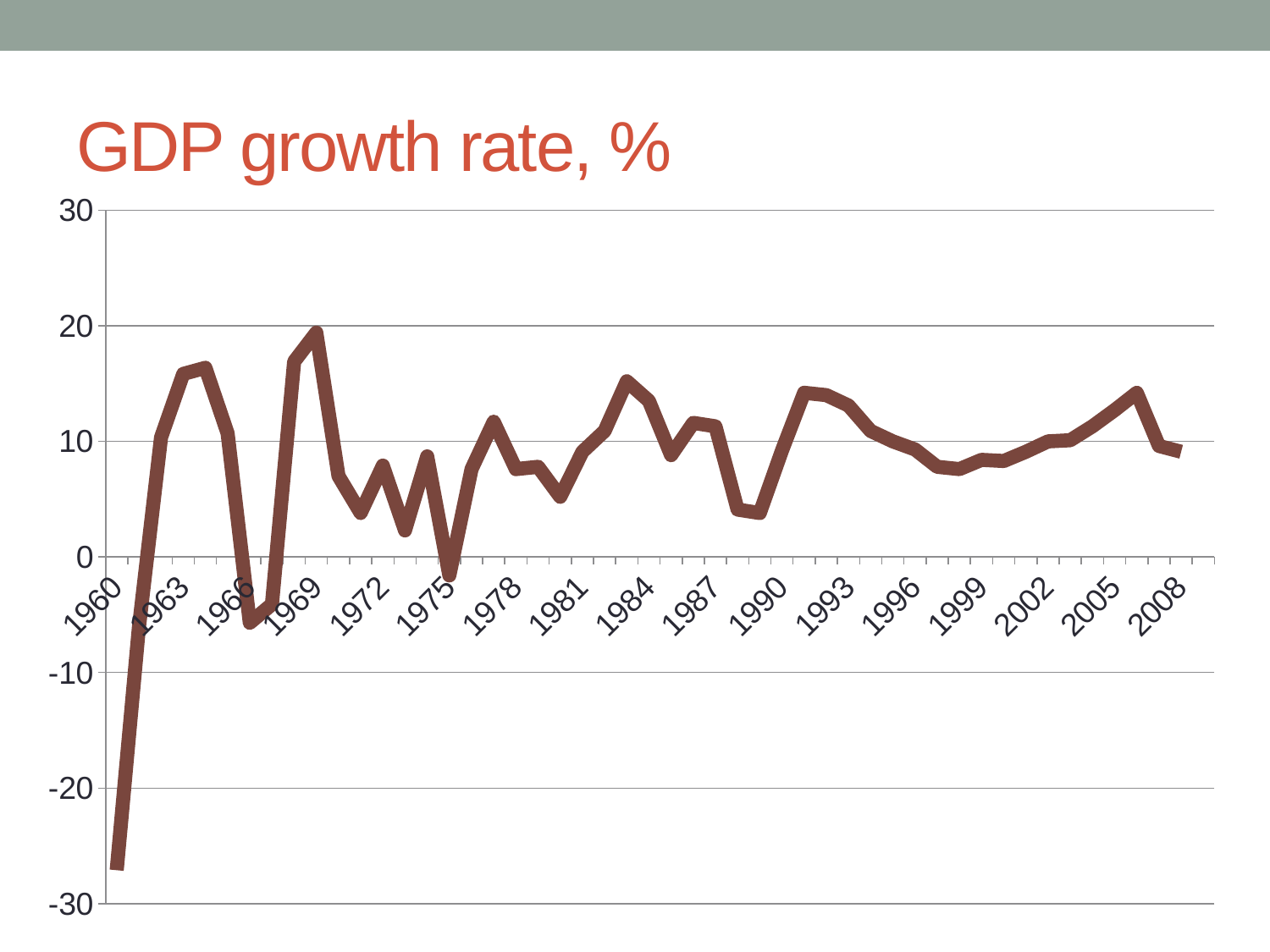
Is the value for 1984 greater or less than 10? greater What kind of chart is shown on the slide? line chart Does the GDP growth rate rise or fall between 1960 and 1963? rise Which year has the lowest GDP growth rate on the chart? 1960 Is the value for 2005 greater or less than 10? greater Is the value for 1969 greater or less than 10? greater What are the lowest and highest values shown on the vertical axis? -30 and 30 What is the title of the chart? GDP growth rate, % Which is larger, the value for 1960 or the value for 1969? 1969